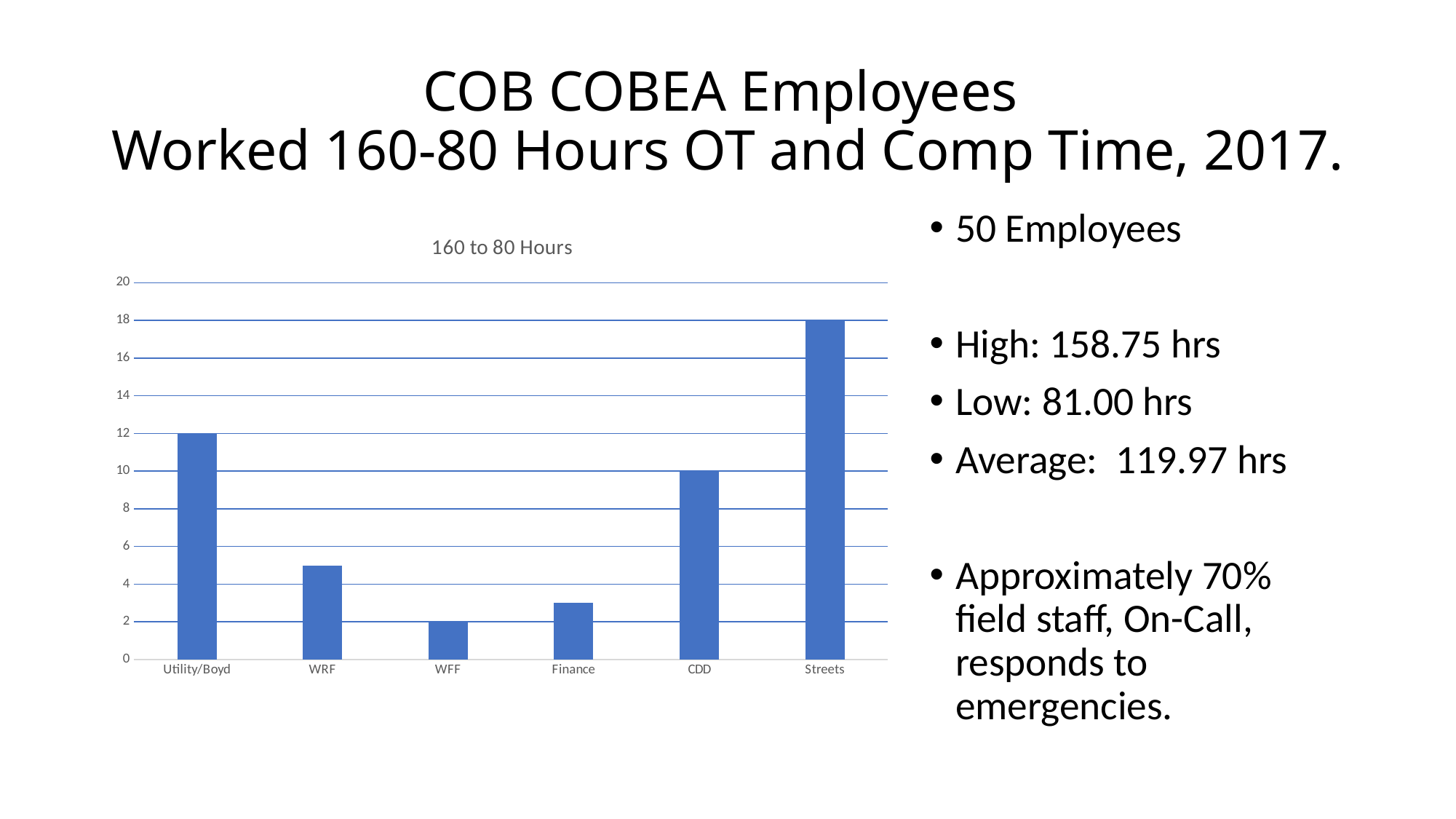
What is the difference between the values for Streets and Utility/Boyd? 6 How many categories are shown on the x axis of the chart? 6 Which category has the lowest value? WFF What type of chart is shown on the slide? bar chart What is the title of the chart? 160 to 80 Hours Which category has the highest value? Streets What is the value for CDD? 10 Is the value for WRF greater or less than 4? greater What is the value for Utility/Boyd? 12 What is the value for Streets? 18 Which is larger, the value for CDD or the value for WRF? CDD What is the value for WFF? 2